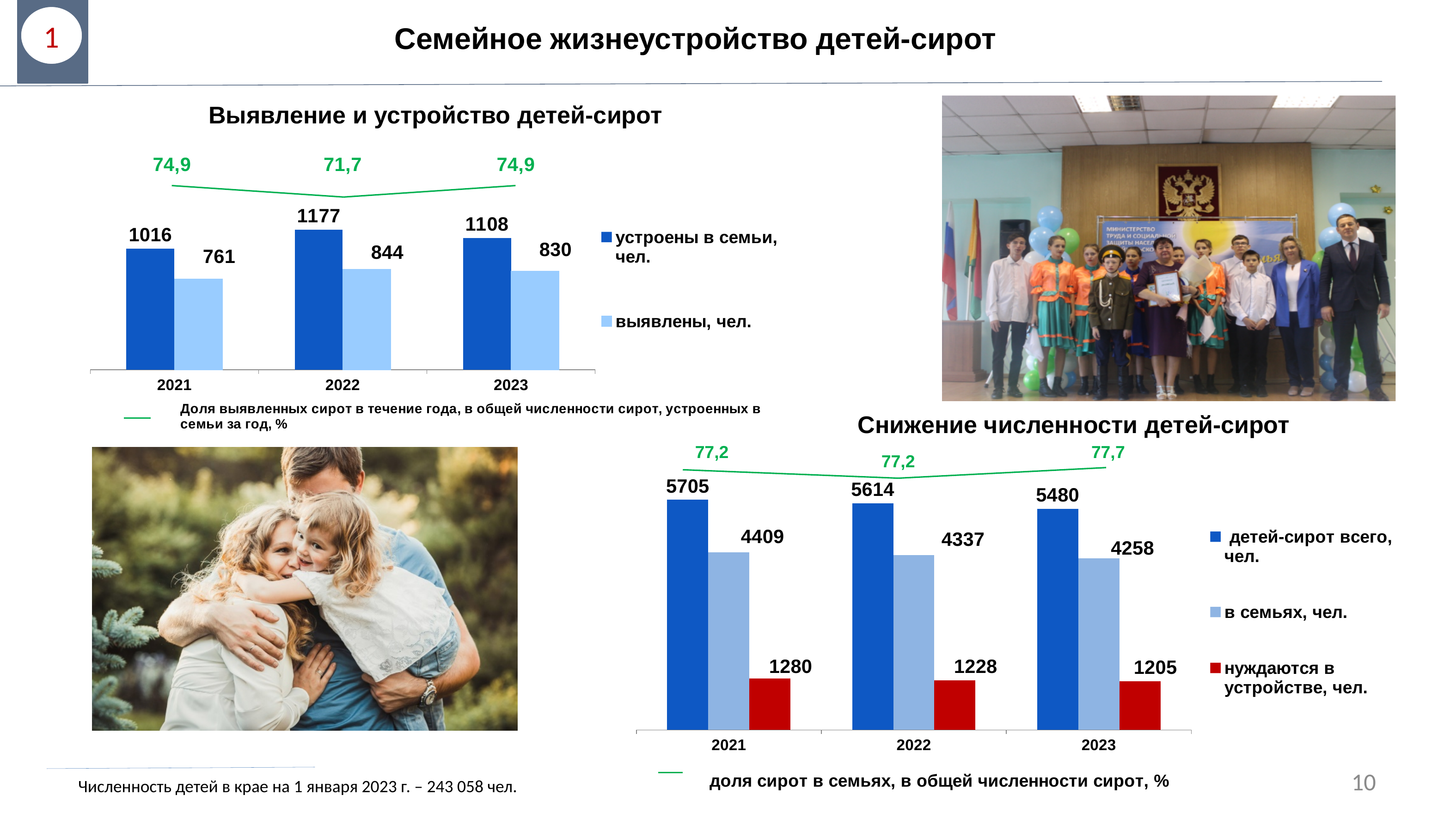
In the chart 'Снижение численности детей-сирот', which year has the lowest value for 'в семьях, чел.'? 2023 In the chart 'Снижение численности детей-сирот', what is the difference between 'детей-сирот всего, чел.' in 2021 and 2022? 91 In the chart 'Снижение численности детей-сирот', what is the value of 'детей-сирот всего, чел.' for 2023? 5480 In the chart 'Снижение численности детей-сирот', what is the value of 'нуждаются в устройстве, чел.' for 2022? 1228 In the chart 'Выявление и устройство детей-сирот', what is the value of 'устроены в семьи, чел.' for 2022? 1177 In the chart 'Выявление и устройство детей-сирот', which year has the highest value for 'устроены в семьи, чел.'? 2022 In the chart 'Выявление и устройство детей-сирот', what is the share value shown by the green line for 2022? 71,7 In the chart 'Выявление и устройство детей-сирот', what is the difference between 'устроены в семьи, чел.' and 'выявлены, чел.' in 2023? 278 In the chart 'Снижение численности детей-сирот', does the value of 'детей-сирот всего, чел.' rise or fall from 2021 to 2023? fall In the chart 'Выявление и устройство детей-сирот', what is the value of 'выявлены, чел.' for 2021? 761 What kind of chart is 'Снижение численности детей-сирот'? bar chart In the chart 'Выявление и устройство детей-сирот', how many series does the legend list? 2